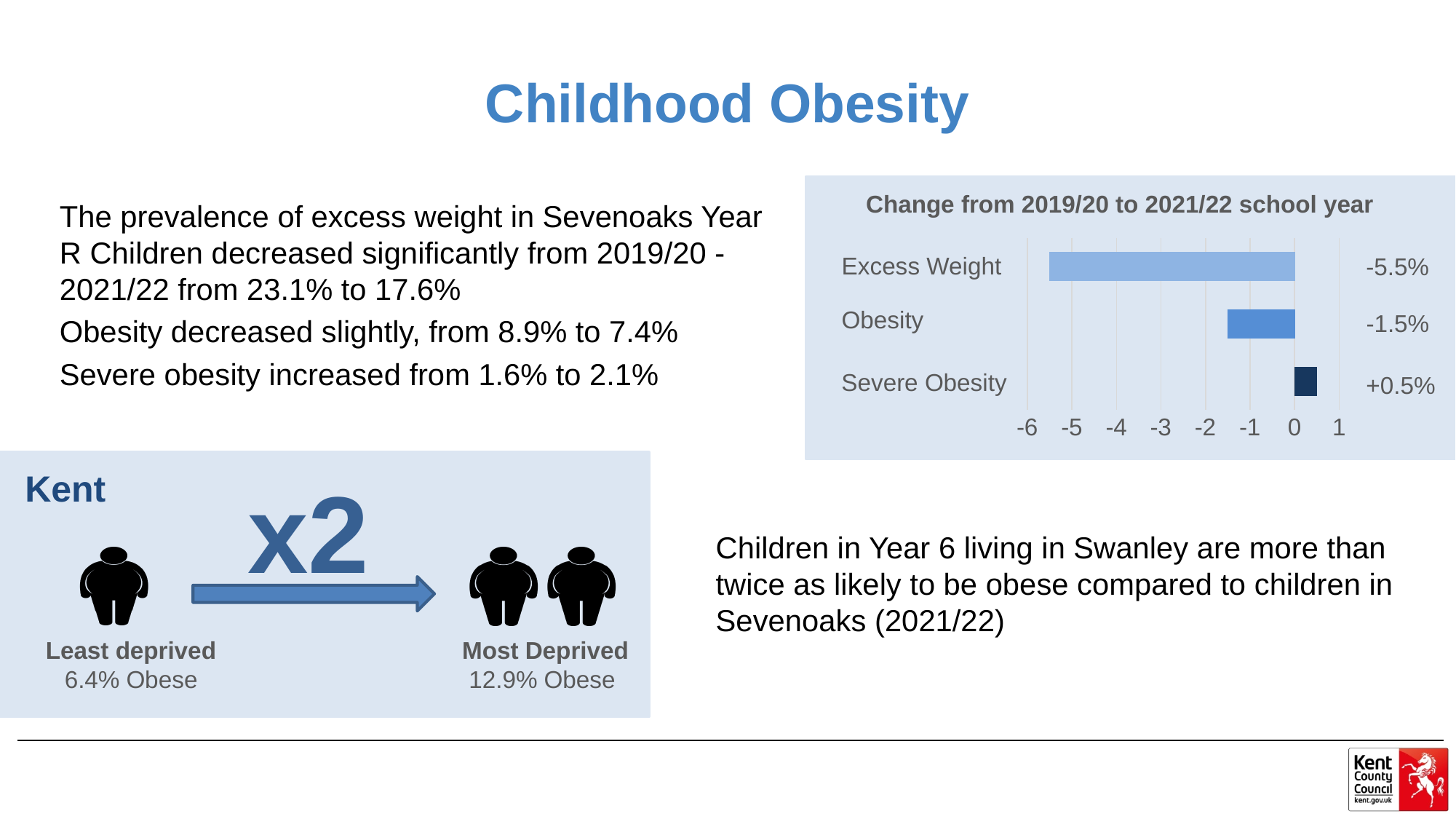
In the 'Change from 2019/20 to 2021/22 school year' chart, which has a larger decrease: Excess Weight or Obesity? Excess Weight What is the title of the bar chart on the slide? Change from 2019/20 to 2021/22 school year Which category in the 'Change from 2019/20 to 2021/22 school year' chart is the only one with a positive change? Severe Obesity Which category in the 'Change from 2019/20 to 2021/22 school year' chart has the largest decrease? Excess Weight How many categories are shown in the 'Change from 2019/20 to 2021/22 school year' chart? 3 In the 'Change from 2019/20 to 2021/22 school year' chart, is the value for Obesity greater or less than -2? greater In the 'Change from 2019/20 to 2021/22 school year' chart, what is the difference between the Excess Weight change and the Obesity change? 4 percentage points What kind of chart is the 'Change from 2019/20 to 2021/22 school year' chart? Bar chart What is the value for Obesity in the 'Change from 2019/20 to 2021/22 school year' chart? -1.5% In the 'Change from 2019/20 to 2021/22 school year' chart, is the value for Excess Weight greater or less than -5? less What is the value for Excess Weight in the 'Change from 2019/20 to 2021/22 school year' chart? -5.5% What is the value for Severe Obesity in the 'Change from 2019/20 to 2021/22 school year' chart? +0.5%